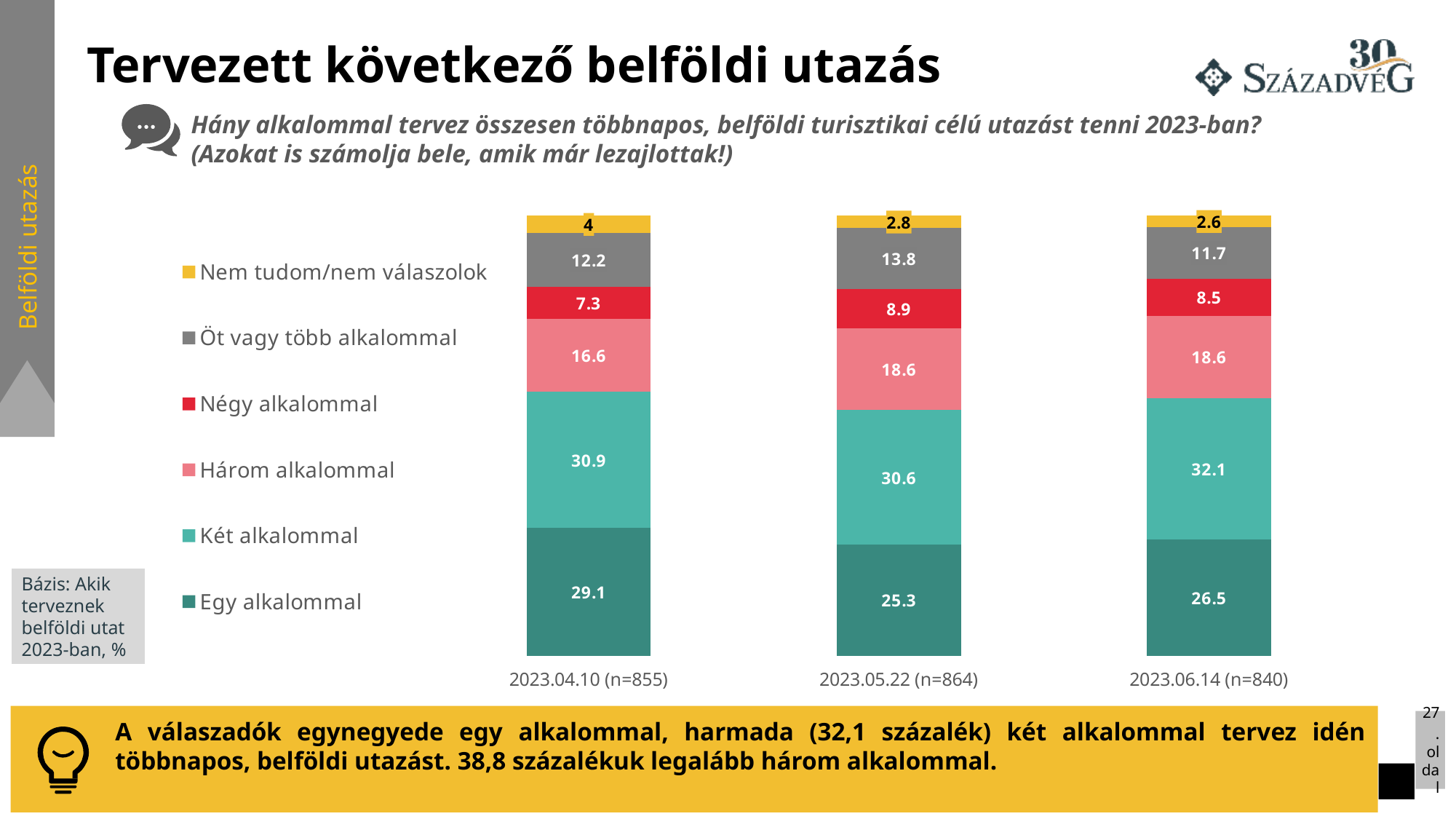
What is the total of the stacked bar for 2023.05.22 (n=864)? 100 What is the value for "Két alkalommal" on 2023.06.14 (n=840)? 32.1 Which date has the larger value for "Négy alkalommal": 2023.05.22 or 2023.06.14? 2023.05.22 What is the value for "Egy alkalommal" on 2023.05.22 (n=864)? 25.3 How many series does the legend list? 6 How many survey dates are shown on the x axis? 3 By how much did the value for "Három alkalommal" change from 2023.04.10 to 2023.05.22? 2 On which date is the value for "Öt vagy több alkalommal" the highest? 2023.05.22 (n=864) On which date is the value for "Egy alkalommal" the lowest? 2023.05.22 (n=864) What is the value for "Nem tudom/nem válaszolok" on 2023.04.10 (n=855)? 4 Does the value for "Nem tudom/nem válaszolok" rise or fall across the three dates? Fall What kind of chart is shown on the slide? Stacked bar chart